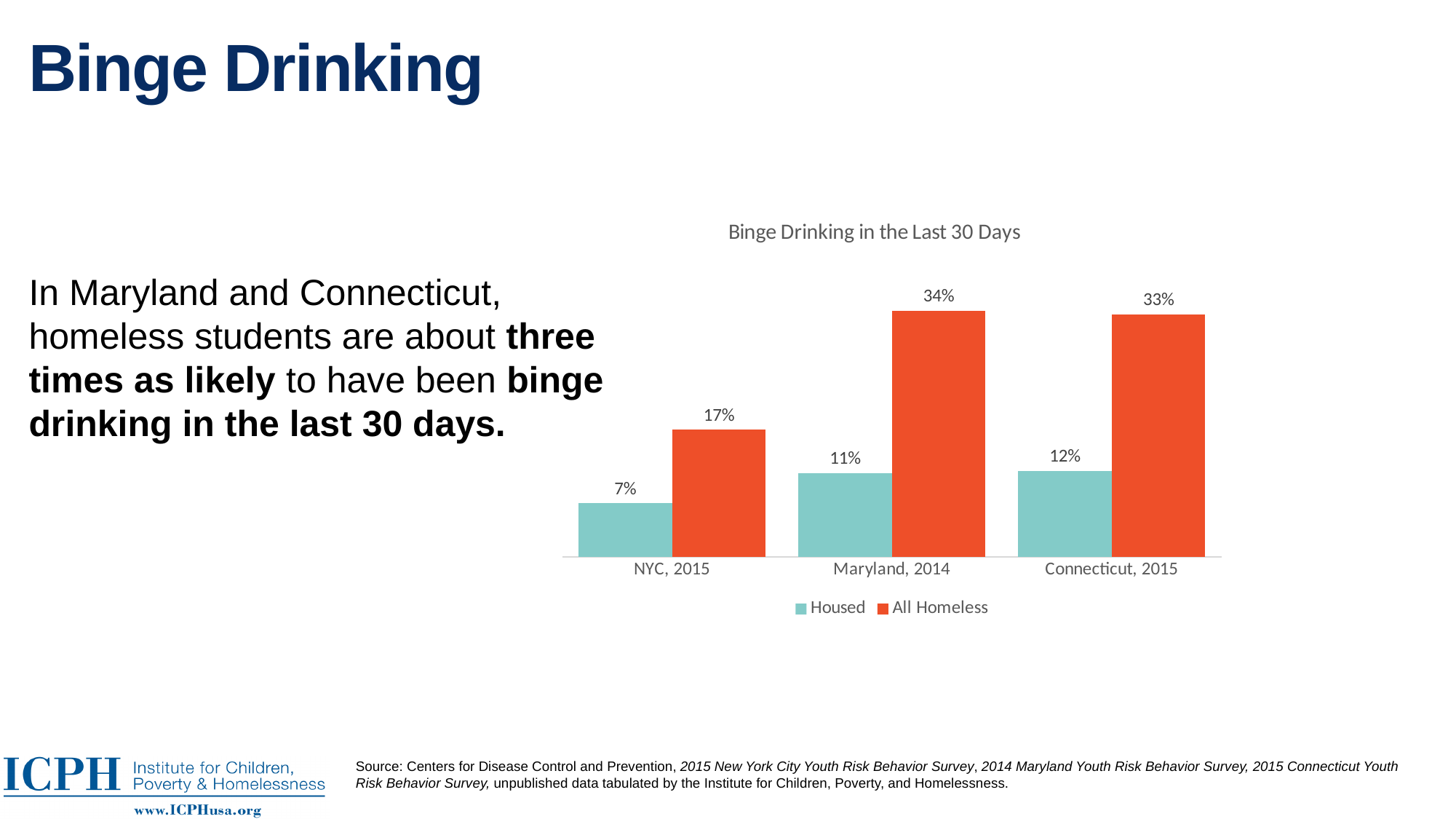
What is the value for All Homeless students in Maryland, 2014? 34% How many series does the legend list? 2 What kind of chart is shown on the slide? Bar chart What is the difference between the All Homeless values for Maryland, 2014 and NYC, 2015? 17% How many categories are shown on the x axis? 3 Which category has the lowest value for Housed students? NYC, 2015 Which is larger: the Housed value in Maryland, 2014 or the Housed value in Connecticut, 2015? Connecticut, 2015 What is the value for Housed students in Connecticut, 2015? 12% What is the value for Housed students in NYC, 2015? 7% Which category has the highest value for All Homeless students? Maryland, 2014 What is the difference between the All Homeless and Housed values in Connecticut, 2015? 21% What is the title of the chart? Binge Drinking in the Last 30 Days